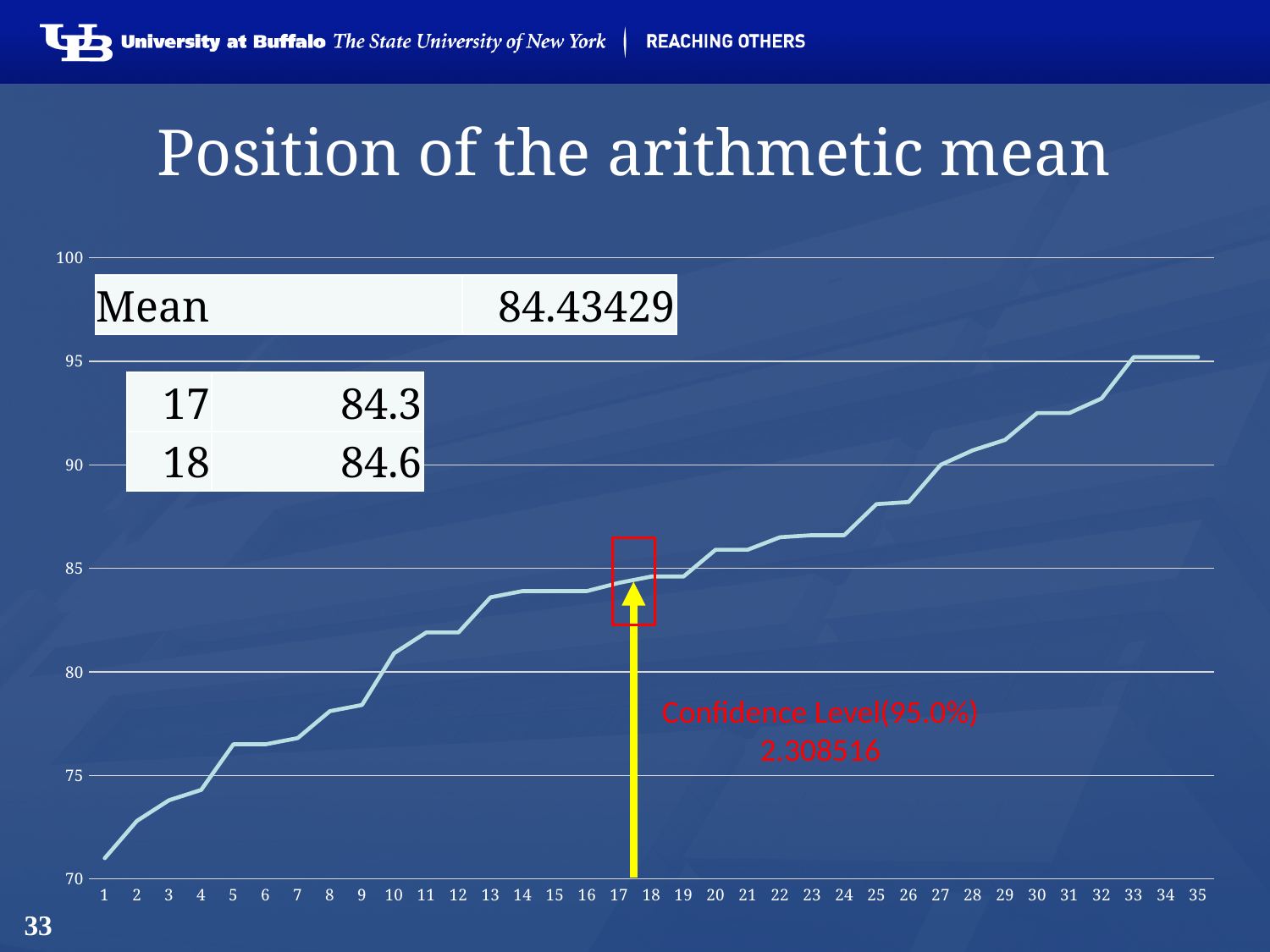
What is the title of the chart on the slide? Position of the arithmetic mean What is the value at position 17 according to the table on the chart? 84.3 Is the value for position 1 greater or less than 75? less What is the difference between the values at positions 18 and 17? 0.3 Is the value for position 27 greater or less than 85? greater Do the values rise or fall as the x axis goes from 1 to 35? rise Which has the larger value, position 17 or position 18? 18 What kind of chart is shown on the slide? line chart What is the value at position 18 according to the table on the chart? 84.6 How many points are plotted along the x axis of the chart? 35 Which position has the lowest value on the chart? 1 What mean value is shown in the table on the chart? 84.43429